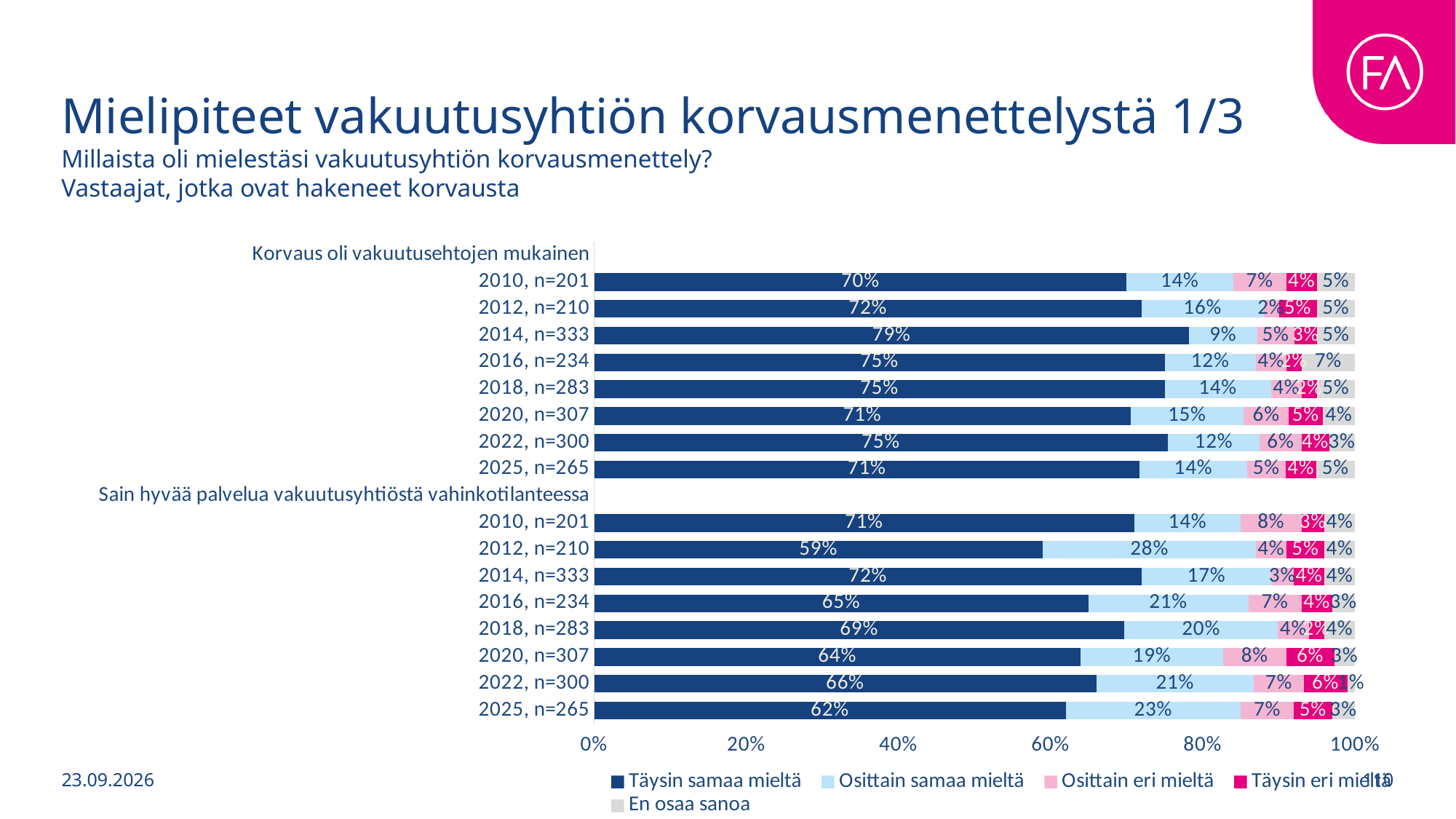
What is the 'Täysin samaa mieltä' value for 2025, n=265 in the 'Sain hyvää palvelua vakuutusyhtiöstä vahinkotilanteessa' group? 62% In the 'Korvaus oli vakuutusehtojen mukainen' group, which year has the highest 'Täysin samaa mieltä' share? 2014, n=333 In the 'Sain hyvää palvelua vakuutusyhtiöstä vahinkotilanteessa' group, what is the 'Osittain samaa mieltä' share for 2012, n=210? 28% In the 'Sain hyvää palvelua vakuutusyhtiöstä vahinkotilanteessa' group, which year has the lowest 'Täysin samaa mieltä' share? 2012, n=210 How many bars are plotted in the chart in total? 16 How many series does the legend list? 5 Is the 'Täysin samaa mieltä' value for 2012, n=210 in the 'Sain hyvää palvelua vakuutusyhtiöstä vahinkotilanteessa' group greater or less than 60%? less What percentage of respondents in 2010 (n=201) fully agreed (Täysin samaa mieltä) that the compensation was in line with the insurance terms (Korvaus oli vakuutusehtojen mukainen)? 70% What kind of chart is shown on the slide? Stacked horizontal bar chart What is the difference between the 'Täysin samaa mieltä' share for 2014, n=333 and 2010, n=201 in the 'Korvaus oli vakuutusehtojen mukainen' group? 9 percentage points Which legend entry is shown in dark blue? Täysin samaa mieltä Which is larger: the 'Täysin samaa mieltä' share for 2022, n=300 in the 'Korvaus oli vakuutusehtojen mukainen' group or in the 'Sain hyvää palvelua vakuutusyhtiöstä vahinkotilanteessa' group? Korvaus oli vakuutusehtojen mukainen (75%)